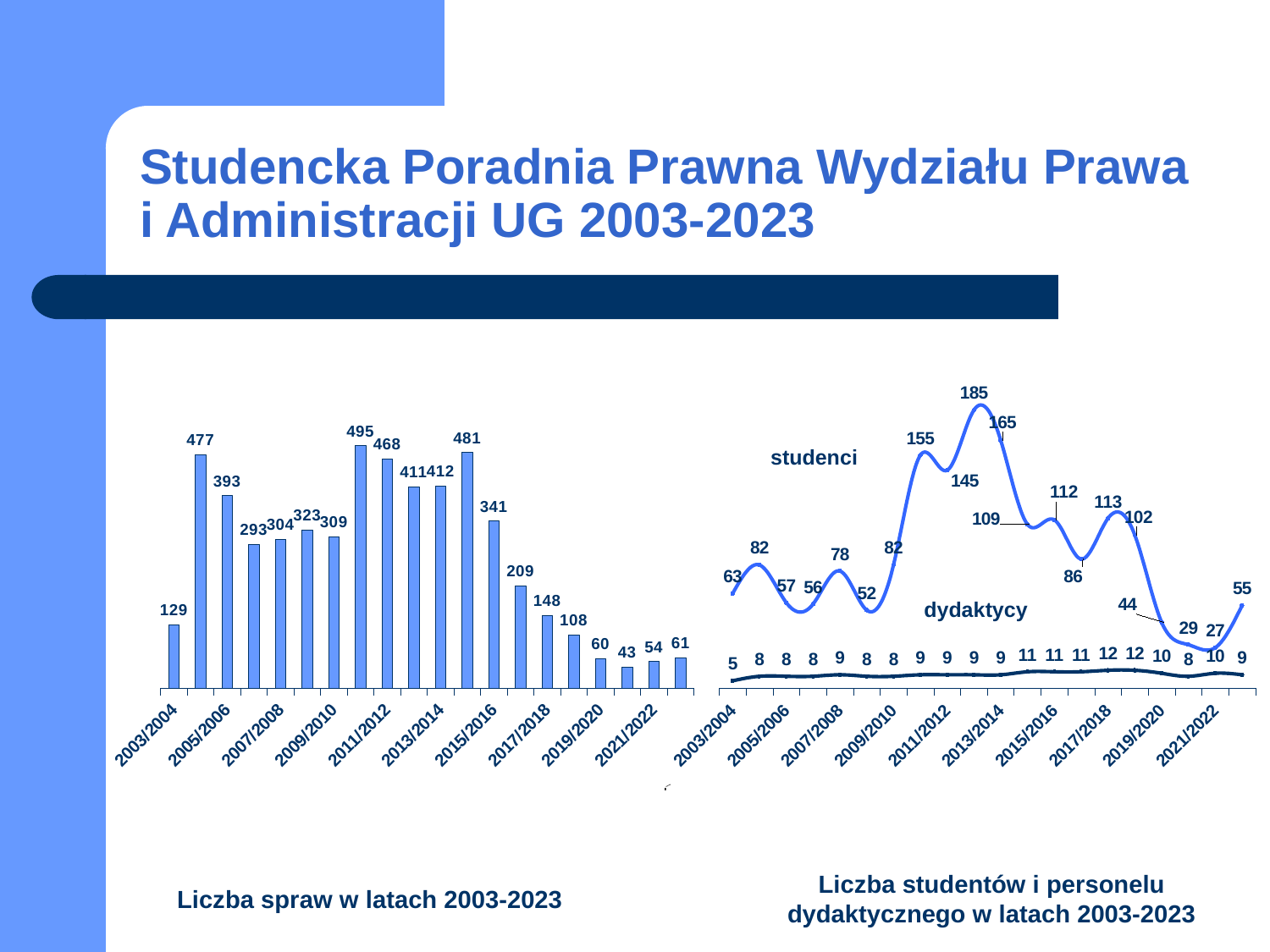
In the left chart 'Liczba spraw w latach 2003-2023', what is the difference between the highest value (495) and the lowest value (43)? 452 In the right chart, what is the lowest value of the 'dydaktycy' series? 5 How many series are plotted in the right chart 'Liczba studentów i personelu dydaktycznego w latach 2003-2023'? 2 What kind of chart is the left chart, 'Liczba spraw w latach 2003-2023'? bar chart How many bars are plotted in the left chart 'Liczba spraw w latach 2003-2023'? 20 In the right chart, what is the lowest value of the 'studenci' series? 27 In the left chart 'Liczba spraw w latach 2003-2023', what is the highest value shown? 495 In the left chart 'Liczba spraw w latach 2003-2023', what is the value for 2003/2004? 129 In the left chart 'Liczba spraw w latach 2003-2023', do the values rise or fall from 2015/2016 to 2019/2020? fall In the left chart 'Liczba spraw w latach 2003-2023', what is the lowest value shown? 43 What kind of chart is the right chart, 'Liczba studentów i personelu dydaktycznego w latach 2003-2023'? line chart In the right chart, what is the highest value of the 'studenci' series? 185